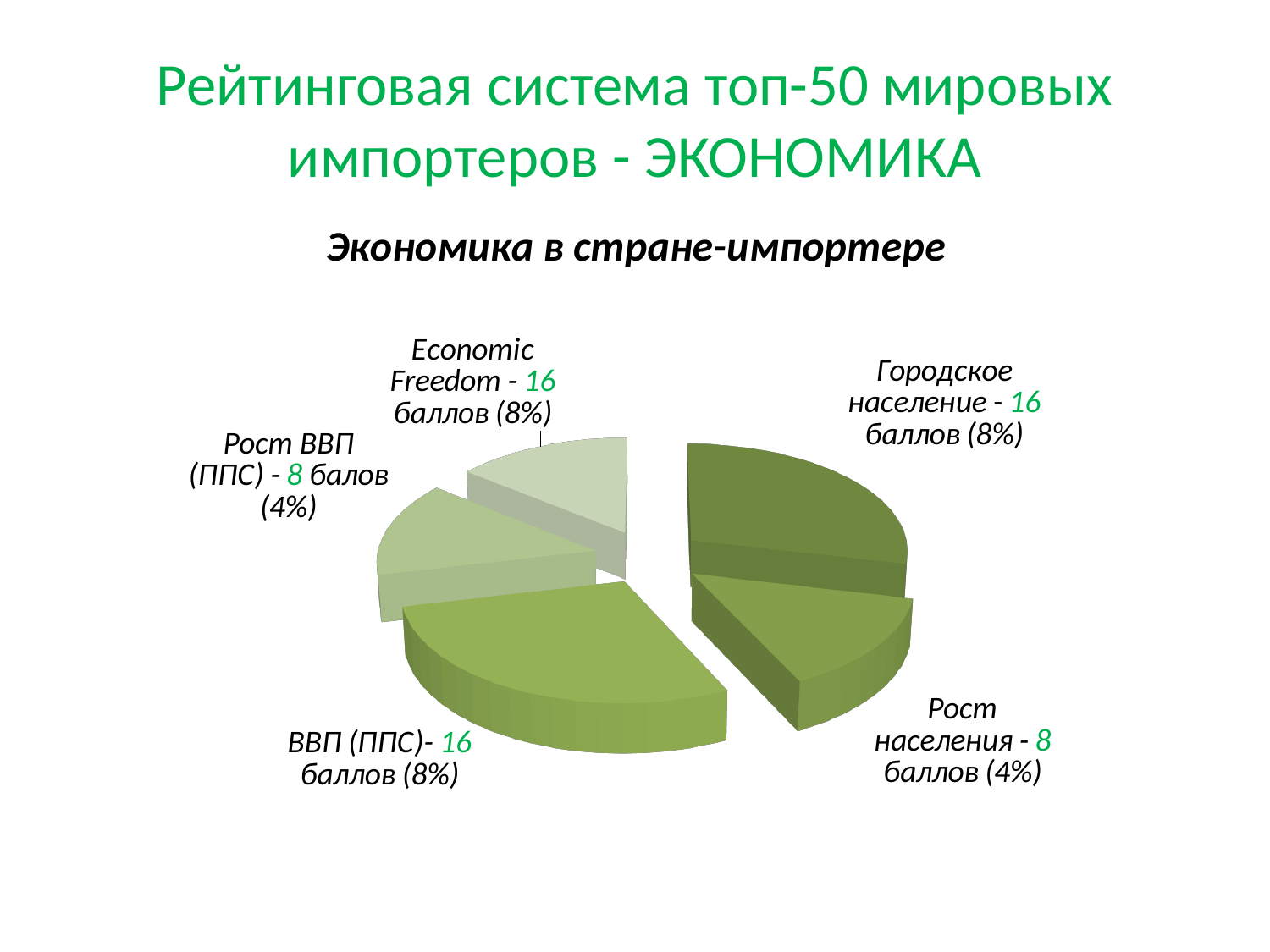
How many points does the slice 'Economic Freedom' have? 16 баллов How many points does the slice 'Рост ВВП (ППС)' have? 8 балов What kind of chart is shown on the slide? Pie chart How many slices does the pie chart have? 5 How many points does the slice 'ВВП (ППС)' have? 16 баллов How many points (баллов) does the slice 'Городское население' have? 16 баллов What is the difference in points between 'ВВП (ППС)' and 'Рост ВВП (ППС)'? 8 How many points does the slice 'Рост населения' have? 8 баллов What share of the pie does the 'Рост населения' slice represent? 4% What is the title of the pie chart? Экономика в стране-импортере What share of the pie does the 'Economic Freedom' slice represent? 8% Which has more points: 'Городское население' or 'Рост населения'? Городское население